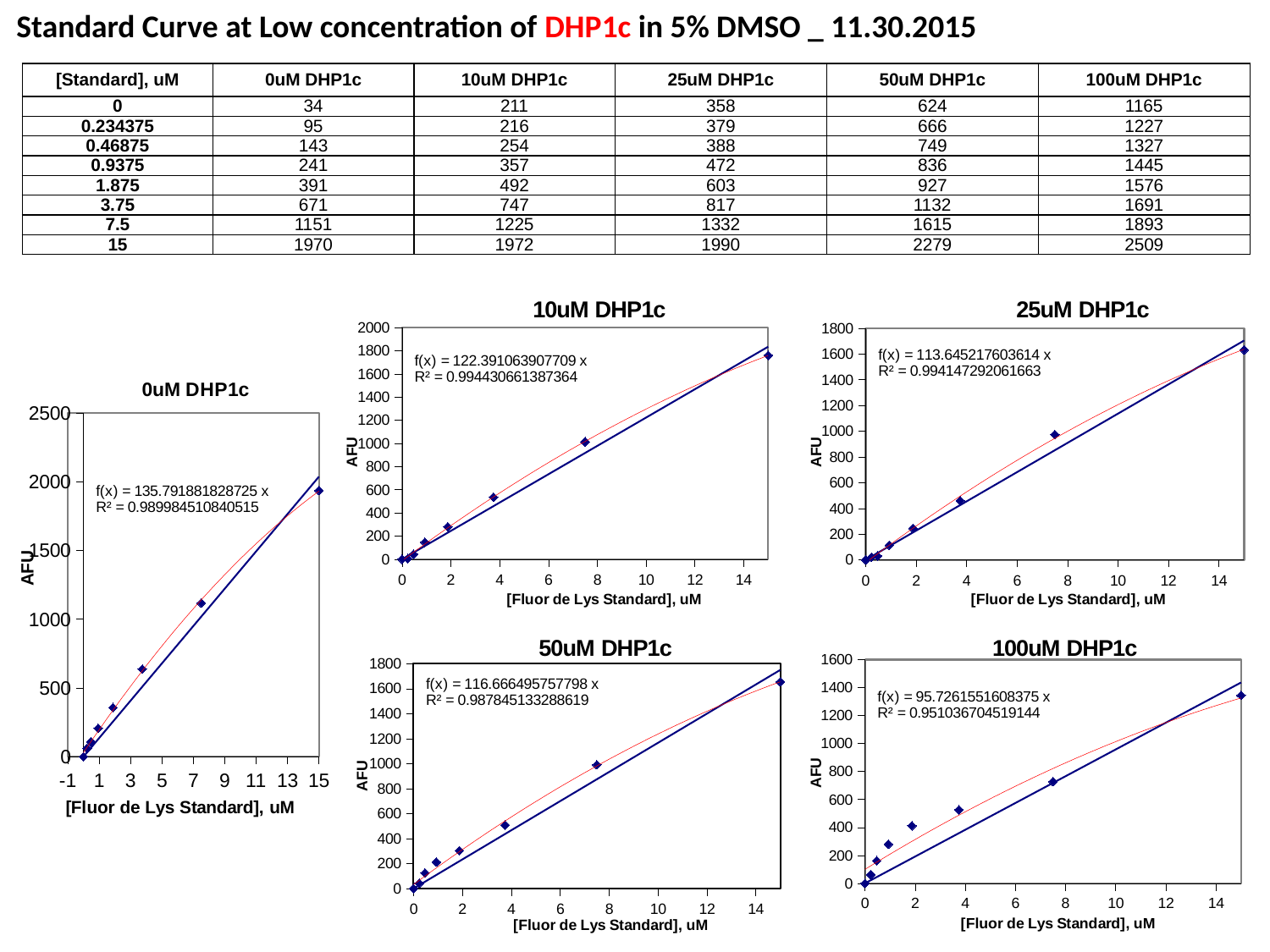
In the 50uM DHP1c chart, is the AFU value at 14.x (the rightmost point) greater or less than 1400? greater What is the y-axis label on the 50uM DHP1c chart? AFU What kind of chart is the 0uM DHP1c chart? scatter chart In the 0uM DHP1c chart, what is the slope of the fitted line f(x)? 135.791881828725 In the 100uM DHP1c chart, is the AFU value at the rightmost point (x = 15) greater or less than 1200? greater How many data points are plotted in the 0uM DHP1c chart? 8 Which chart has the larger fitted slope, 0uM DHP1c or 100uM DHP1c? 0uM DHP1c Which of the five charts shows the lowest R² value? 100uM DHP1c Which of the five charts shows the highest R² value? 10uM DHP1c In the 10uM DHP1c chart, what is the fitted equation f(x) shown? f(x) = 122.391063907709 x In the 100uM DHP1c chart, what R² value is shown? R² = 0.951036704519144 In the 25uM DHP1c chart, do the AFU values rise or fall as the standard concentration increases along the x axis? rise